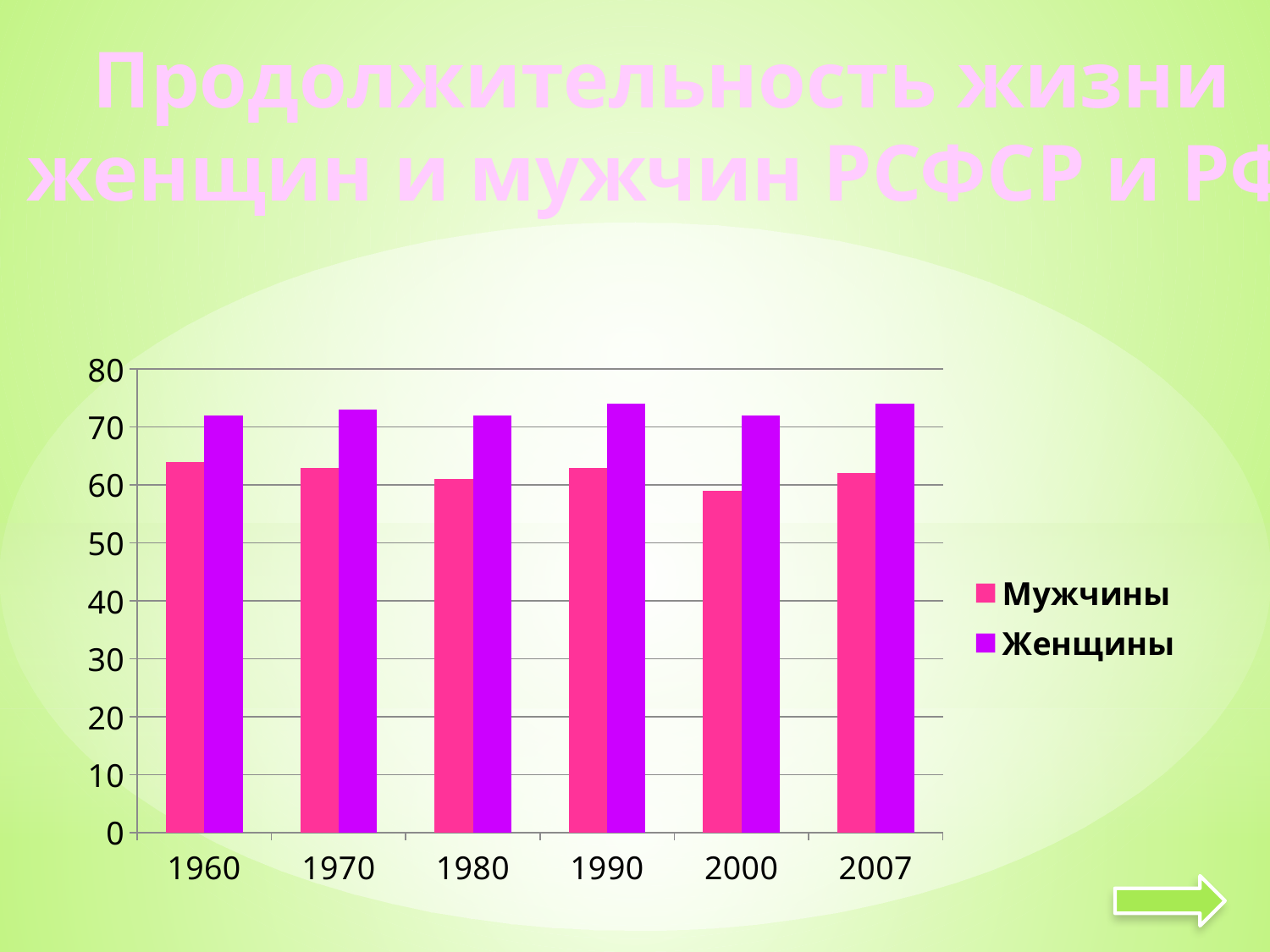
What are the two series named in the chart's legend? Мужчины and Женщины Is the value for Женщины in 1990 greater or less than 70? greater Is the value for Мужчины in 1960 greater or less than 60? greater In 1990, which series has the larger value, Мужчины or Женщины? Женщины How many years are shown on the x axis of the chart? 6 What kind of chart is shown on the slide? bar chart How many series does the chart's legend list? 2 Is the value for Мужчины in 1960 greater or less than 70? less In 2000, which series has the smaller value, Мужчины or Женщины? Мужчины Which colour represents the Женщины series in the chart? purple